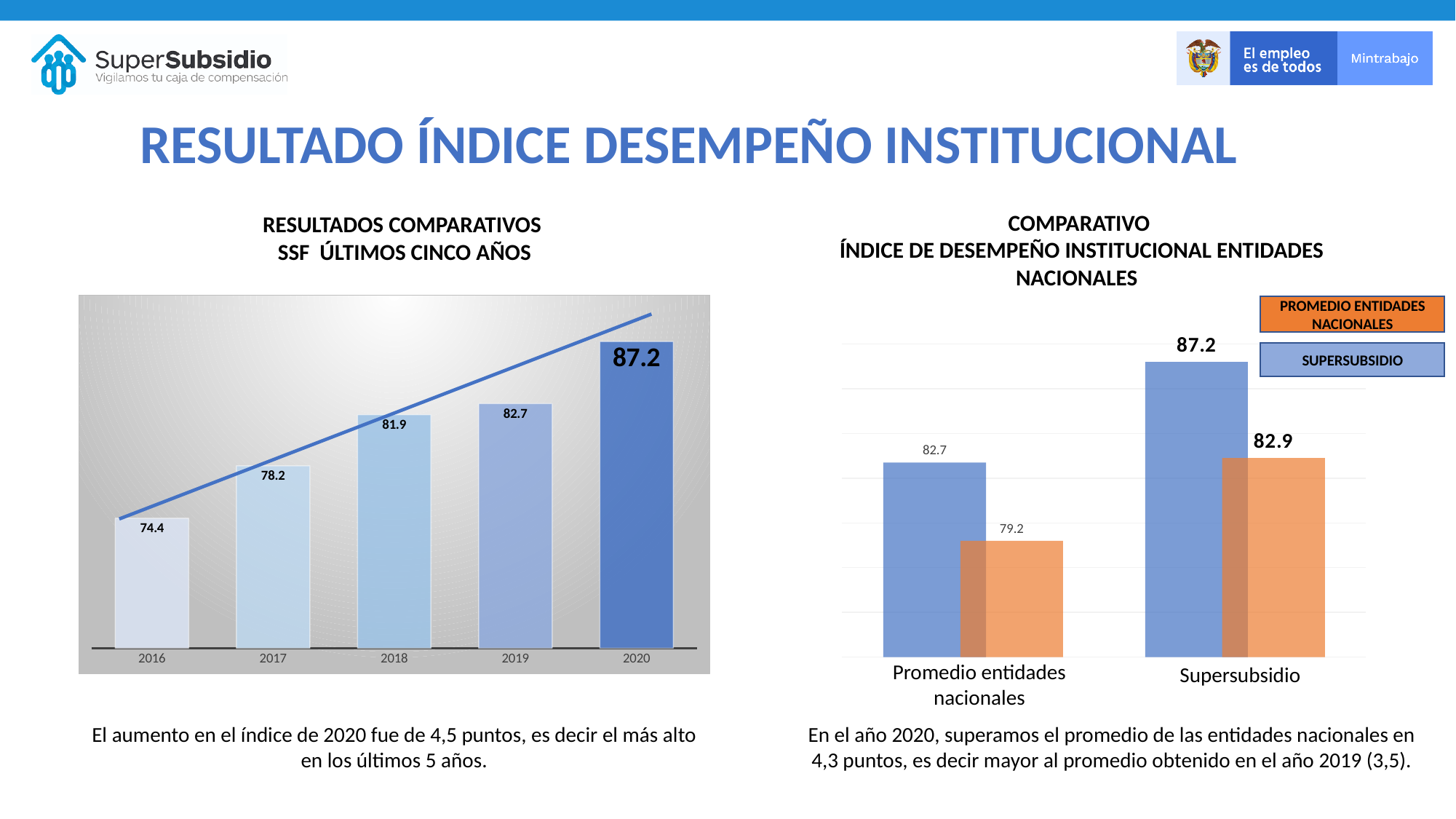
In the left chart (RESULTADOS COMPARATIVOS SSF ÚLTIMOS CINCO AÑOS), which year has the lowest value? 2016 In the left chart (RESULTADOS COMPARATIVOS SSF ÚLTIMOS CINCO AÑOS), how many years are shown? 5 In the left chart (RESULTADOS COMPARATIVOS SSF ÚLTIMOS CINCO AÑOS), what is the value for 2018? 81.9 In the left chart (RESULTADOS COMPARATIVOS SSF ÚLTIMOS CINCO AÑOS), do the values rise or fall from 2016 to 2020? rise In the left chart (RESULTADOS COMPARATIVOS SSF ÚLTIMOS CINCO AÑOS), which year has the highest value? 2020 In the left chart (RESULTADOS COMPARATIVOS SSF ÚLTIMOS CINCO AÑOS), what is the difference between the 2020 value and the 2019 value? 4.5 In the left chart (RESULTADOS COMPARATIVOS SSF ÚLTIMOS CINCO AÑOS), what is the value for 2016? 74.4 In the right chart (COMPARATIVO ÍNDICE DE DESEMPEÑO INSTITUCIONAL ENTIDADES NACIONALES), what is the difference between the blue bar and the orange bar for Supersubsidio? 4.3 In the right chart (COMPARATIVO ÍNDICE DE DESEMPEÑO INSTITUCIONAL ENTIDADES NACIONALES), what is the value of the blue bar for Supersubsidio? 87.2 What kind of chart is the left chart (RESULTADOS COMPARATIVOS SSF ÚLTIMOS CINCO AÑOS)? bar chart In the right chart (COMPARATIVO ÍNDICE DE DESEMPEÑO INSTITUCIONAL ENTIDADES NACIONALES), what is the value of the orange bar for Promedio entidades nacionales? 79.2 In the right chart (COMPARATIVO ÍNDICE DE DESEMPEÑO INSTITUCIONAL ENTIDADES NACIONALES), how many series does the legend list? 2